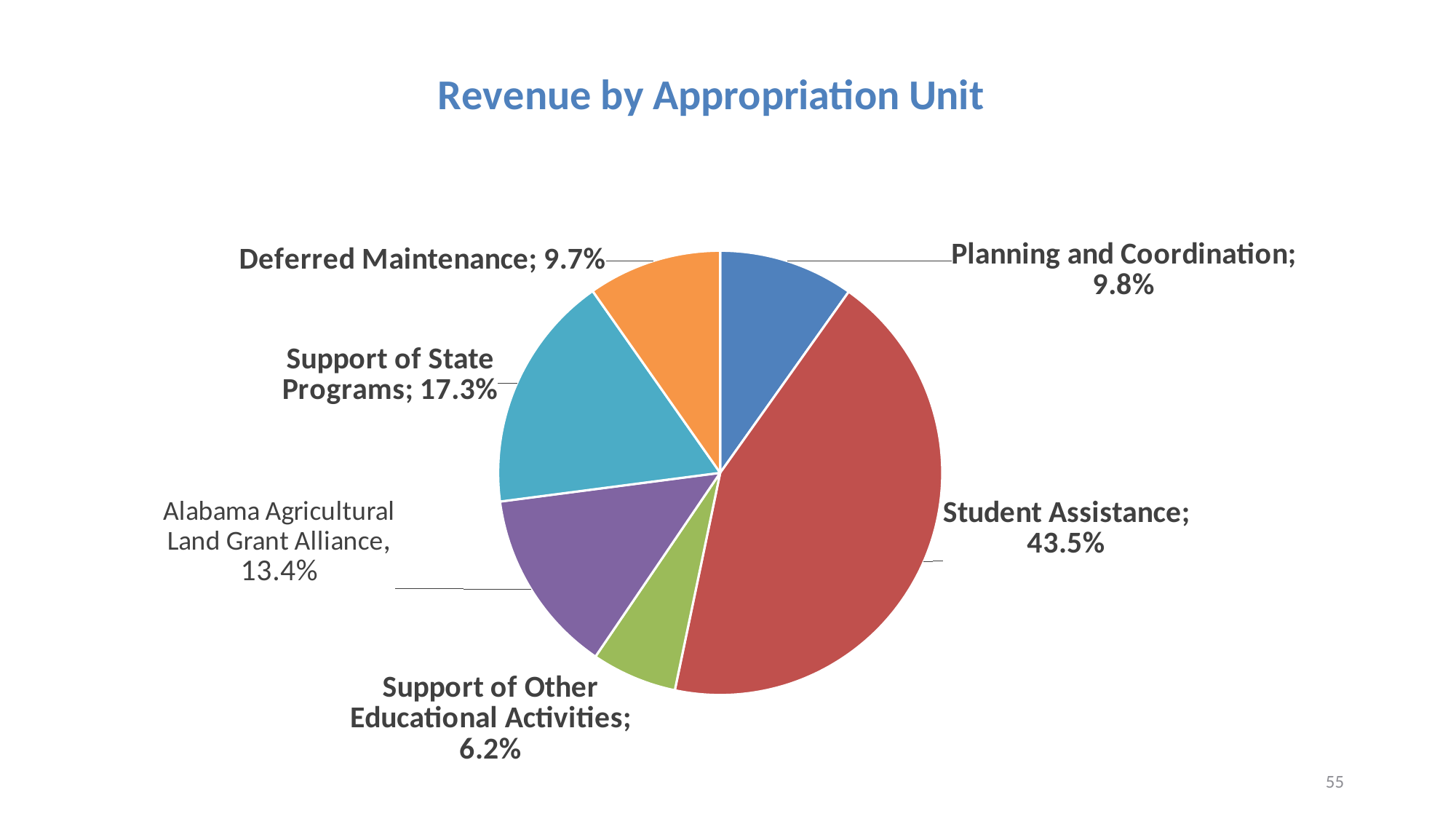
What is the title of the chart? Revenue by Appropriation Unit Which appropriation unit has the smallest share of revenue? Support of Other Educational Activities Which appropriation unit has the largest share of revenue? Student Assistance What share of revenue does Student Assistance account for? 43.5% How many appropriation units are shown in the pie chart? 6 What share of revenue does Deferred Maintenance account for? 9.7% What share of revenue does Support of State Programs account for? 17.3% What type of chart is shown on the slide? Pie chart Which is larger, the share for Support of State Programs or the share for Alabama Agricultural Land Grant Alliance? Support of State Programs What is the difference in percentage points between Student Assistance and Support of State Programs? 26.2 What share of revenue does Support of Other Educational Activities account for? 6.2% What share of revenue does the Alabama Agricultural Land Grant Alliance account for? 13.4%